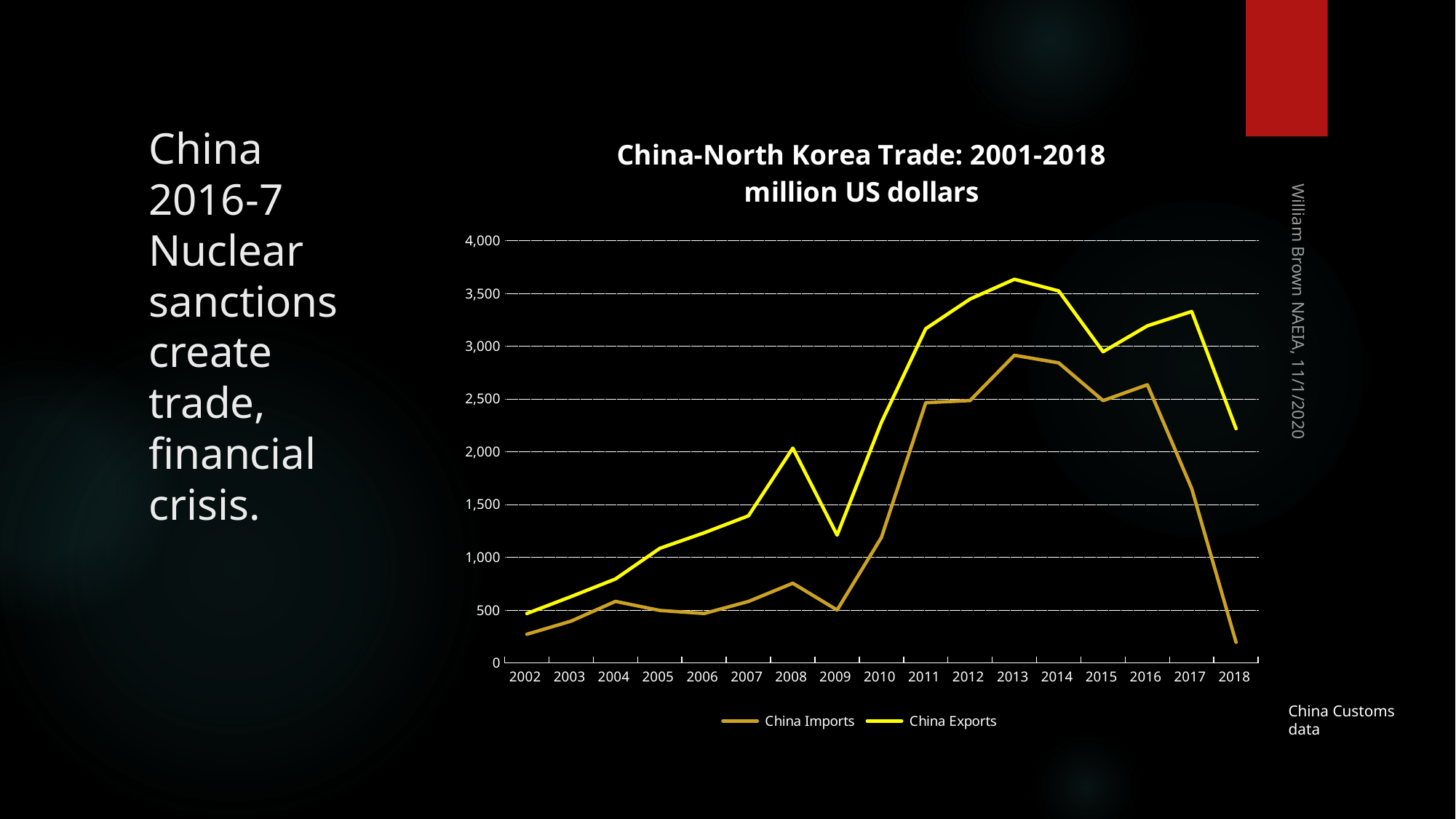
Which is larger in 2010, China Imports or China Exports? China Exports How many years are plotted along the x axis? 17 Is the value for China Exports in 2013 greater or less than 3,500? greater In which year are China Imports at their lowest value? 2018 Is the value for China Imports in 2018 greater or less than 500? less Is the value for China Exports in 2009 greater or less than 1,500? less What is the title of the chart? China-North Korea Trade: 2001-2018 million US dollars What kind of chart is shown on the slide? line chart Do China Imports rise or fall from 2016 to 2018? fall How many series does the legend list? 2 In which year do China Imports reach their highest value? 2013 In which year do China Exports reach their highest value? 2013